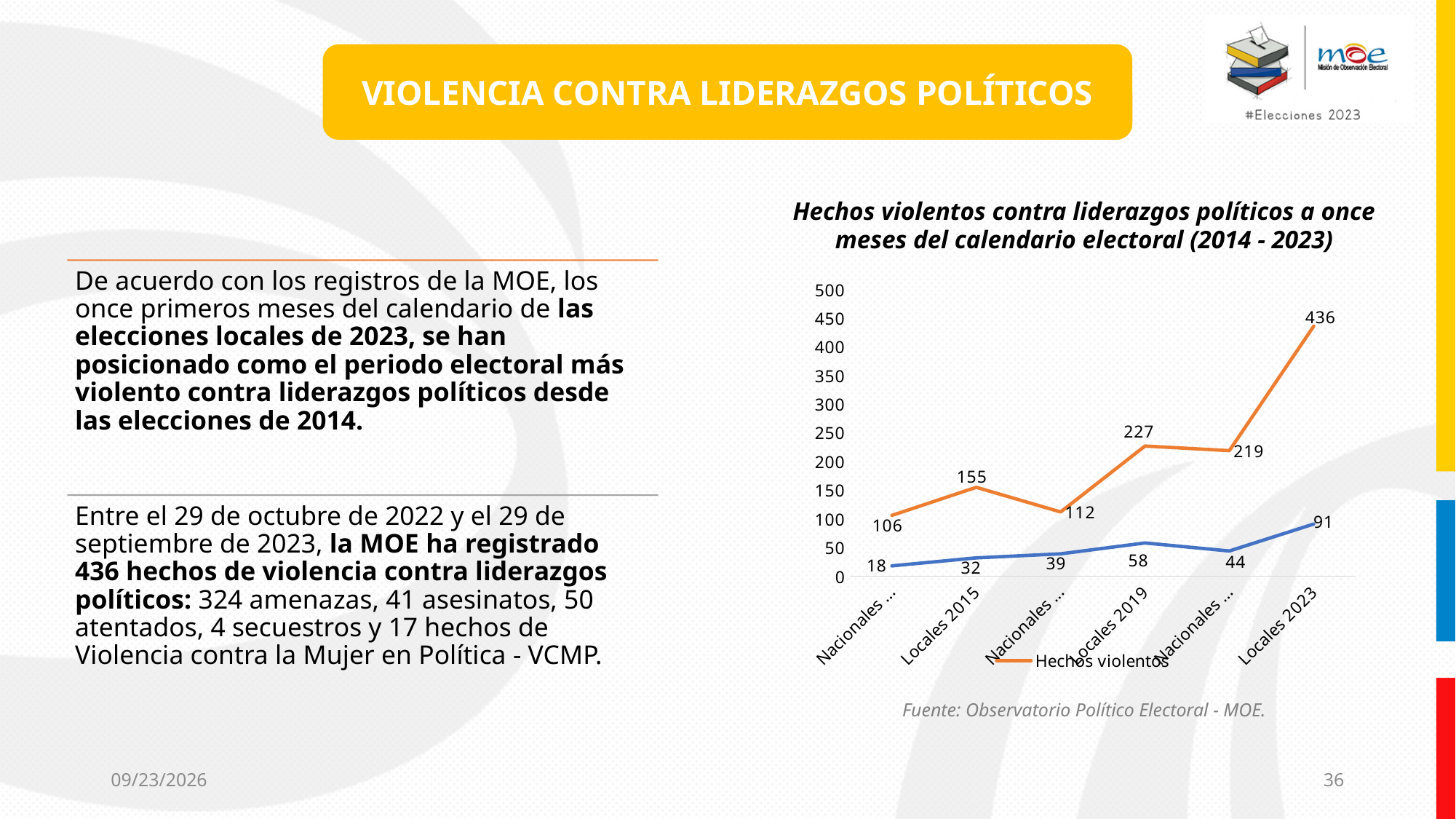
What kind of chart is shown on the slide? line chart What is the value of Hechos violentos for Locales 2015? 155 Which category has the highest value for Hechos violentos? Locales 2023 What is the value of Hechos violentos for Locales 2019? 227 What is the value of the blue line at Locales 2023? 91 What is the difference between the Hechos violentos values for Locales 2023 and Locales 2019? 209 Is the Hechos violentos value for Locales 2023 greater or less than 400? greater Which has a higher Hechos violentos value, Locales 2019 or Locales 2015? Locales 2019 What is the title of the chart? Hechos violentos contra liderazgos políticos a once meses del calendario electoral (2014 - 2023) How many categories are plotted along the x axis? 6 What is the difference between the Hechos violentos values for Locales 2019 and Locales 2015? 72 What is the value of Hechos violentos for Locales 2023? 436